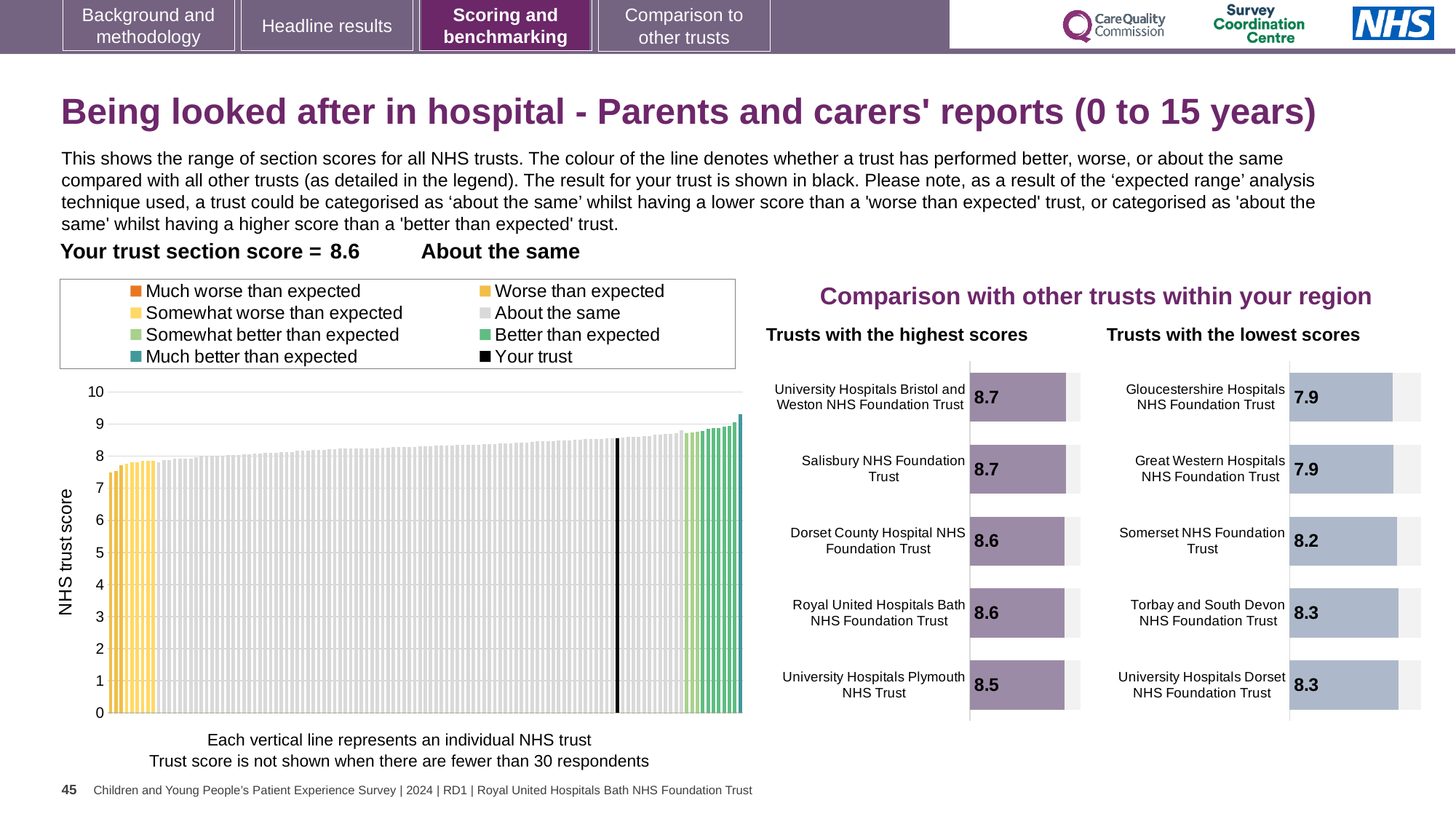
In the 'Trusts with the highest scores' chart, what is the difference between the scores of University Hospitals Bristol and Weston NHS Foundation Trust and University Hospitals Plymouth NHS Trust? 0.2 How many trusts are shown in the 'Trusts with the highest scores' chart? 5 What kind of chart is the main chart on the left showing all NHS trusts? Bar chart In the 'Trusts with the lowest scores' chart, what is the score for Somerset NHS Foundation Trust? 8.2 How many entries does the legend above the main chart on the left list? 8 In the 'Trusts with the lowest scores' chart, what is the score for Gloucestershire Hospitals NHS Foundation Trust? 7.9 In the 'Trusts with the lowest scores' chart, what is the difference between the scores of Somerset NHS Foundation Trust and Great Western Hospitals NHS Foundation Trust? 0.3 In the 'Trusts with the highest scores' chart, which trust has the lowest score? University Hospitals Plymouth NHS Trust In the 'Trusts with the highest scores' chart, what is the score for Salisbury NHS Foundation Trust? 8.7 In the main chart on the left showing all NHS trusts, is the value for the black 'Your trust' bar greater or less than 8? greater In the 'Trusts with the lowest scores' chart, which has the higher score: Somerset NHS Foundation Trust or Torbay and South Devon NHS Foundation Trust? Torbay and South Devon NHS Foundation Trust In the 'Trusts with the highest scores' chart, what is the score for University Hospitals Plymouth NHS Trust? 8.5